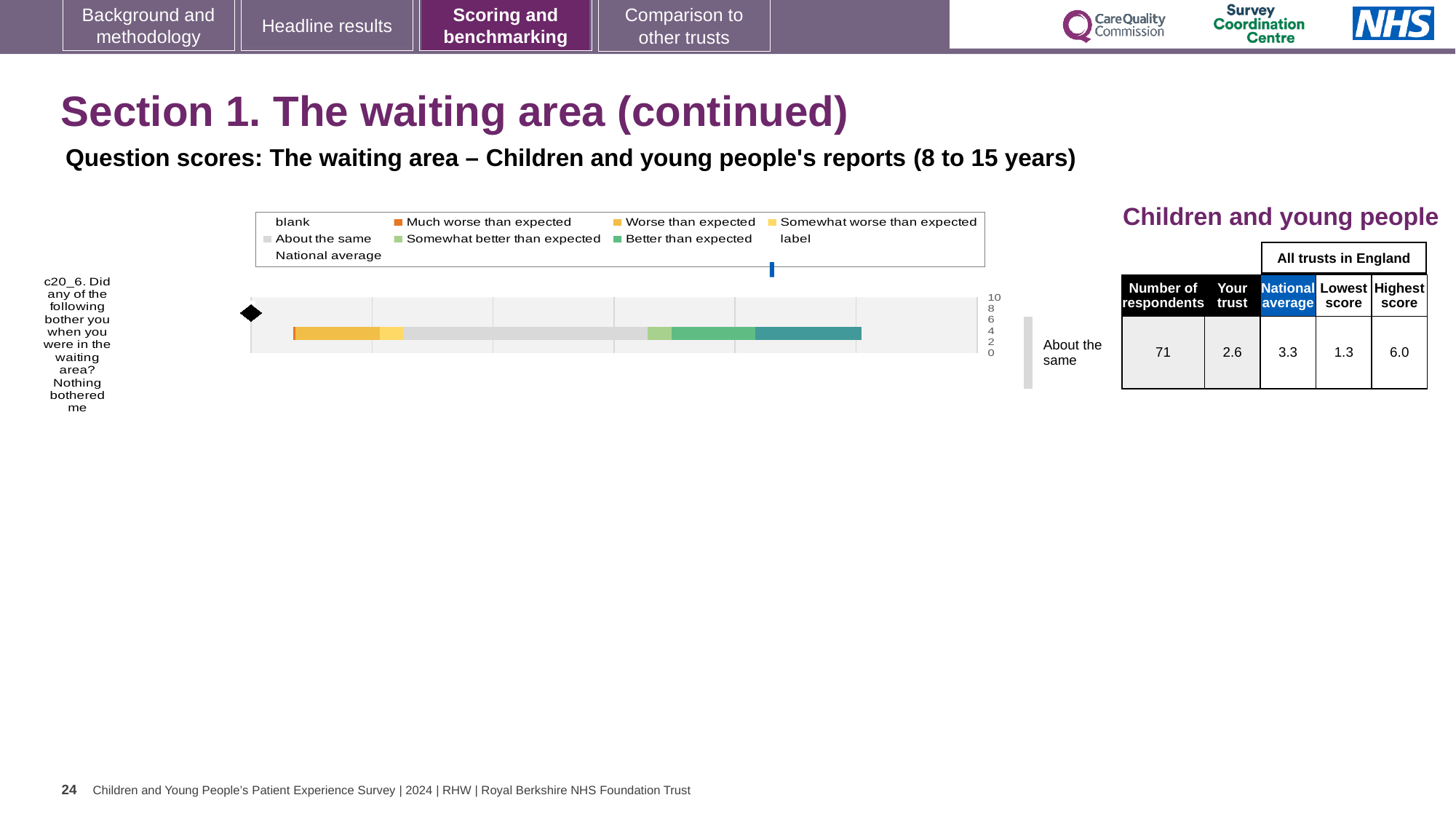
For question c20_6, what is the difference between the highest score and the lowest score across all trusts in England? 4.7 In the table next to the chart, what is the 'Your trust' score for question c20_6? 2.6 For question c20_6, which is larger: the 'Your trust' score or the national average? National average What benchmark label is shown to the right of the bar for question c20_6? About the same What kind of chart is shown on the slide? bar chart In the table next to the chart, how many respondents answered question c20_6? 71 In the table next to the chart, what is the national average score for question c20_6? 3.3 In the table next to the chart, what is the lowest score across all trusts in England for question c20_6? 1.3 How many entries does the chart legend list? 9 Which question is plotted in the bar chart? c20_6. Did any of the following bother you when you were in the waiting area? Nothing bothered me How many question categories are plotted in the bar chart? 1 In the table next to the chart, what is the highest score across all trusts in England for question c20_6? 6.0